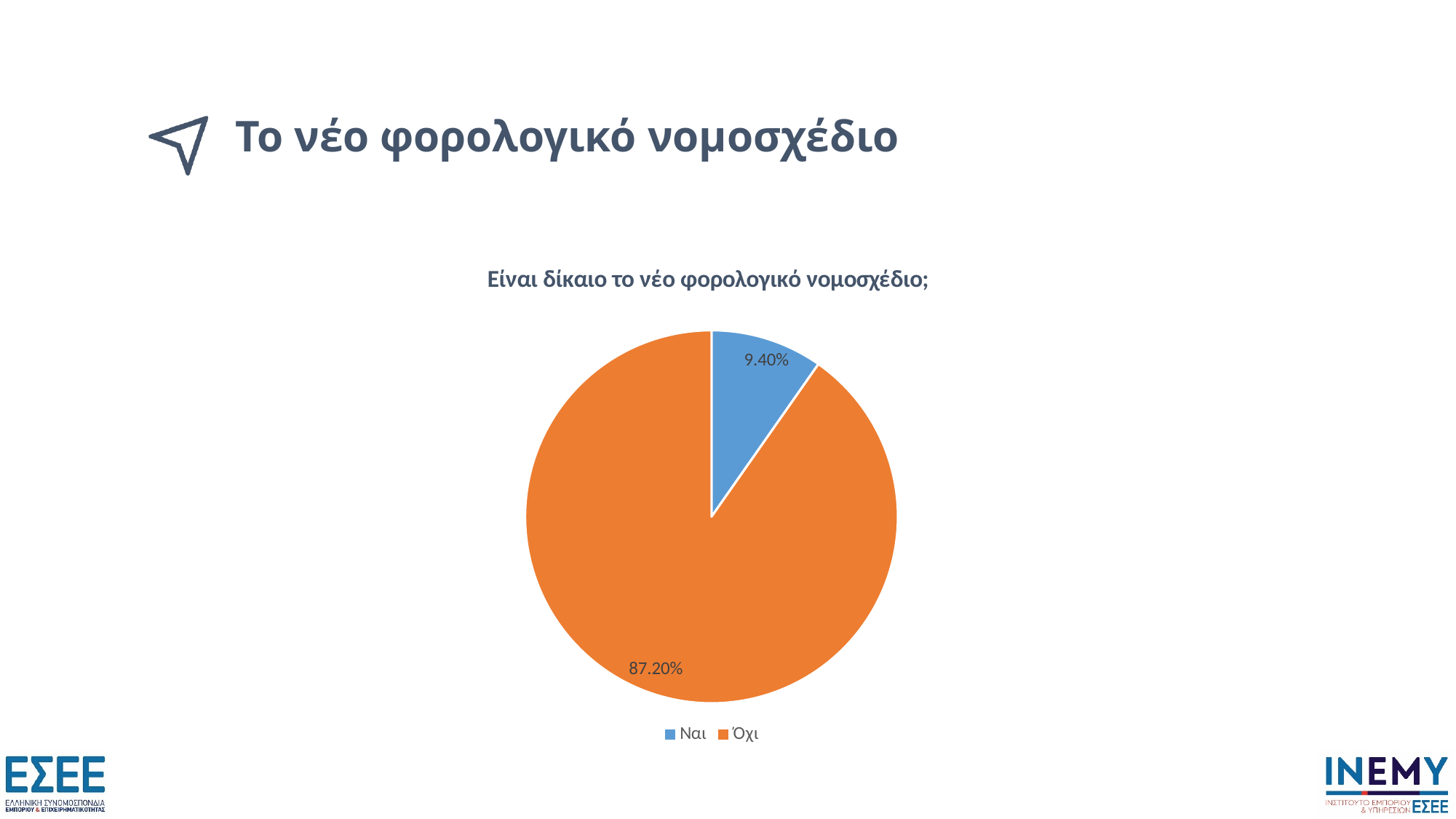
What percentage of the pie is labelled for Ναι? 9.40% Which category has the smallest slice of the pie? Ναι Which category has the largest slice of the pie? Όχι What kind of chart is shown on the slide? Pie chart How many categories does the pie chart show? 2 What colour is the Όχι slice in the pie chart? Orange What share of the pie does the Ναι slice represent? 9.40% What is the difference in percentage points between the Όχι slice and the Ναι slice? 77.80% What is the title of the chart? Είναι δίκαιο το νέο φορολογικό νομοσχέδιο; What percentage of the pie is labelled for Όχι? 87.20% Which slice is larger, Ναι or Όχι? Όχι